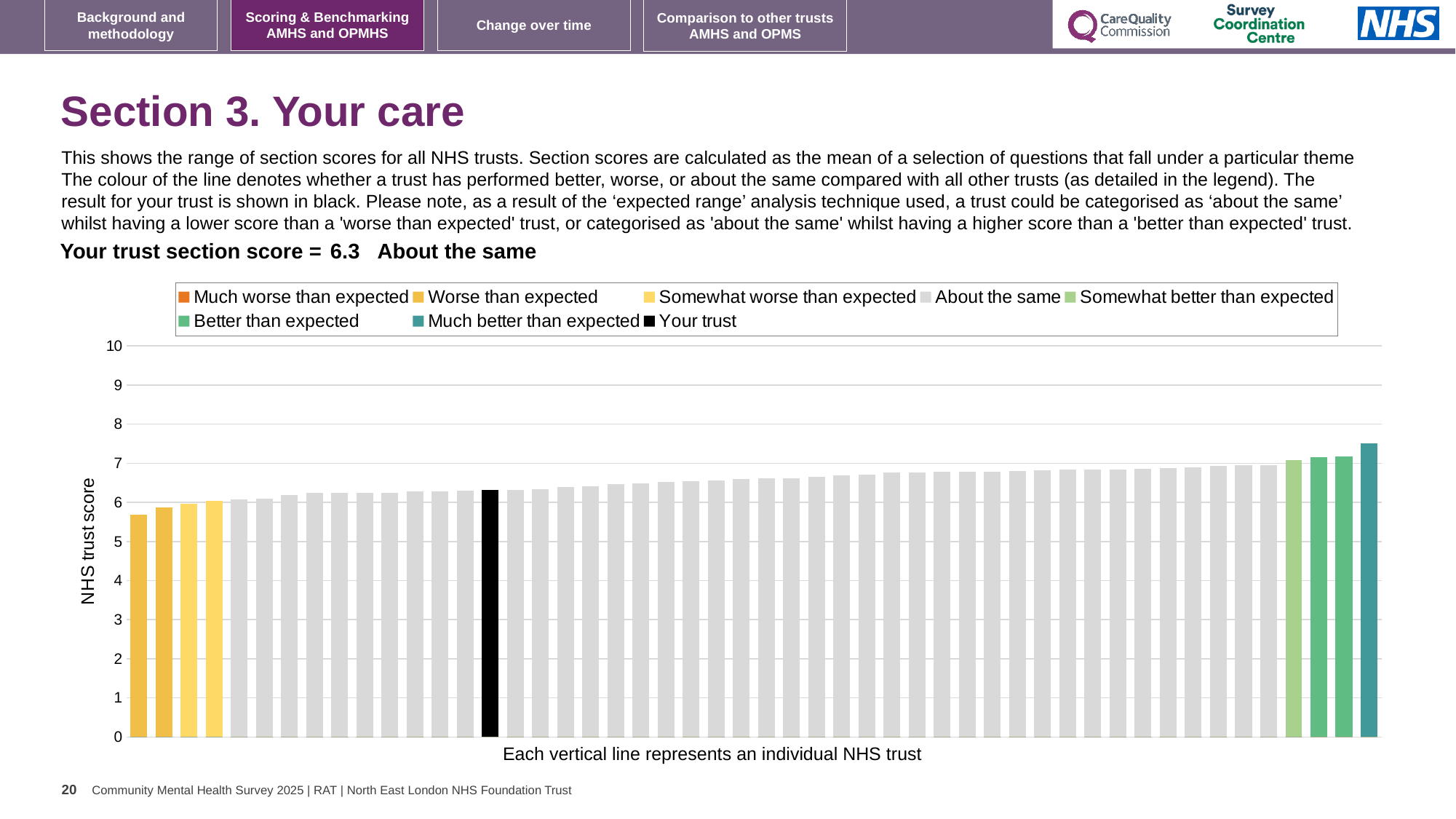
What is the section score for your trust shown on the slide? 6.3 Is the value of the shortest bar on the chart greater or less than 6? less Do the bar values rise or fall from left to right along the x axis? rise How many entries does the chart legend list? 8 What is the maximum value shown on the vertical axis? 10 Is the value of the tallest bar on the chart greater or less than 7? greater What kind of chart is shown on the slide? bar chart Which colour in the legend represents 'Your trust'? black Is the value of the black bar (your trust) greater or less than 6? greater How is your trust's section score categorised compared with other trusts? About the same What is the label on the vertical axis of the chart? NHS trust score